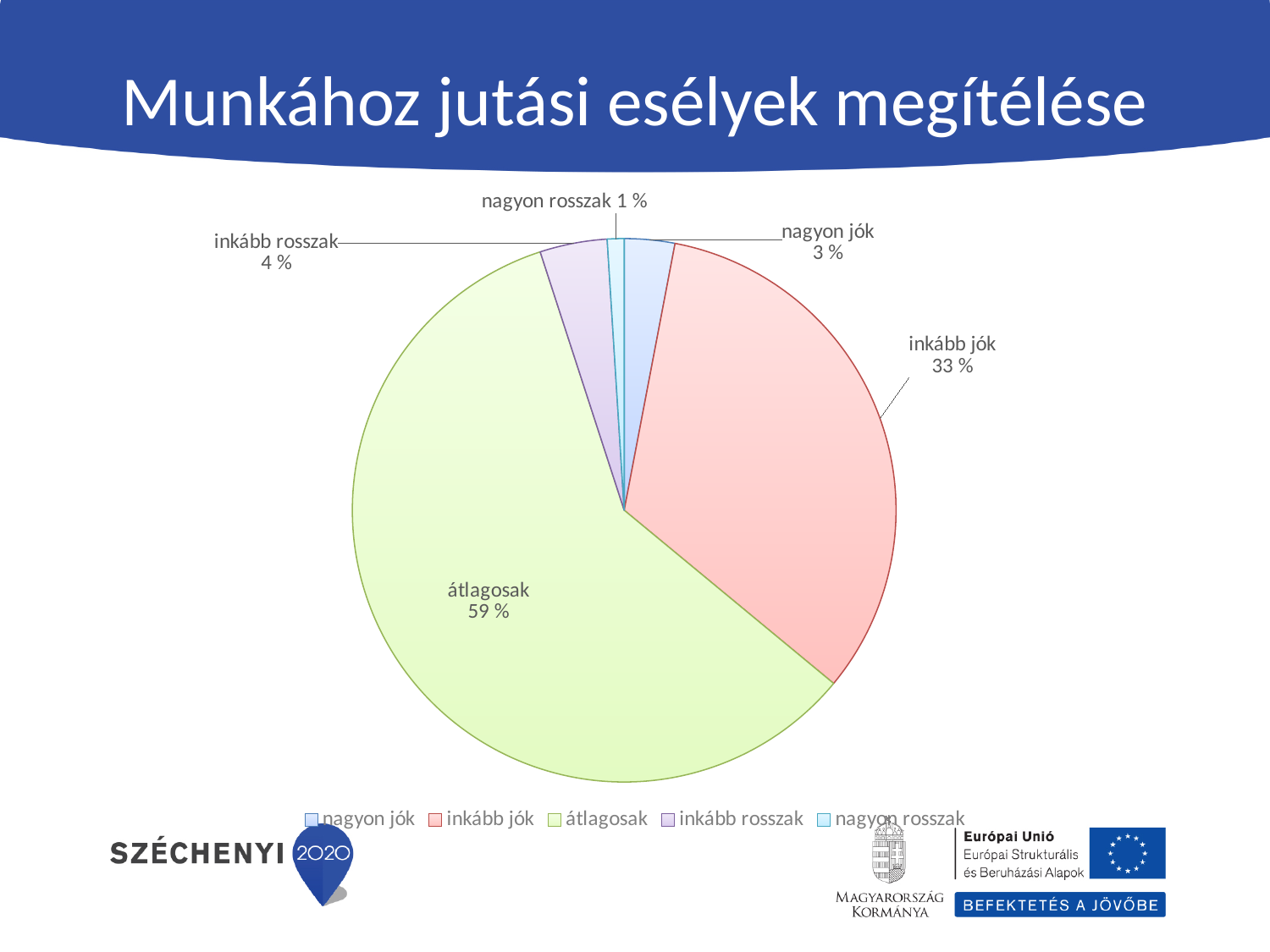
What share of the pie is labelled "átlagosak"? 59 % Which is larger, the share for "inkább rosszak" or the share for "nagyon jók"? inkább rosszak What share of the pie is labelled "inkább jók"? 33 % What is the difference in percentage points between "átlagosak" and "inkább jók"? 26 How many categories does the legend list? 5 What share of the pie is labelled "inkább rosszak"? 4 % What is the title of the slide containing the pie chart? Munkához jutási esélyek megítélése What kind of chart is shown on the slide? pie chart Which category has the smallest slice of the pie? nagyon rosszak What share of the pie is labelled "nagyon rosszak"? 1 % What share of the pie is labelled "nagyon jók"? 3 % Which category has the largest slice of the pie? átlagosak